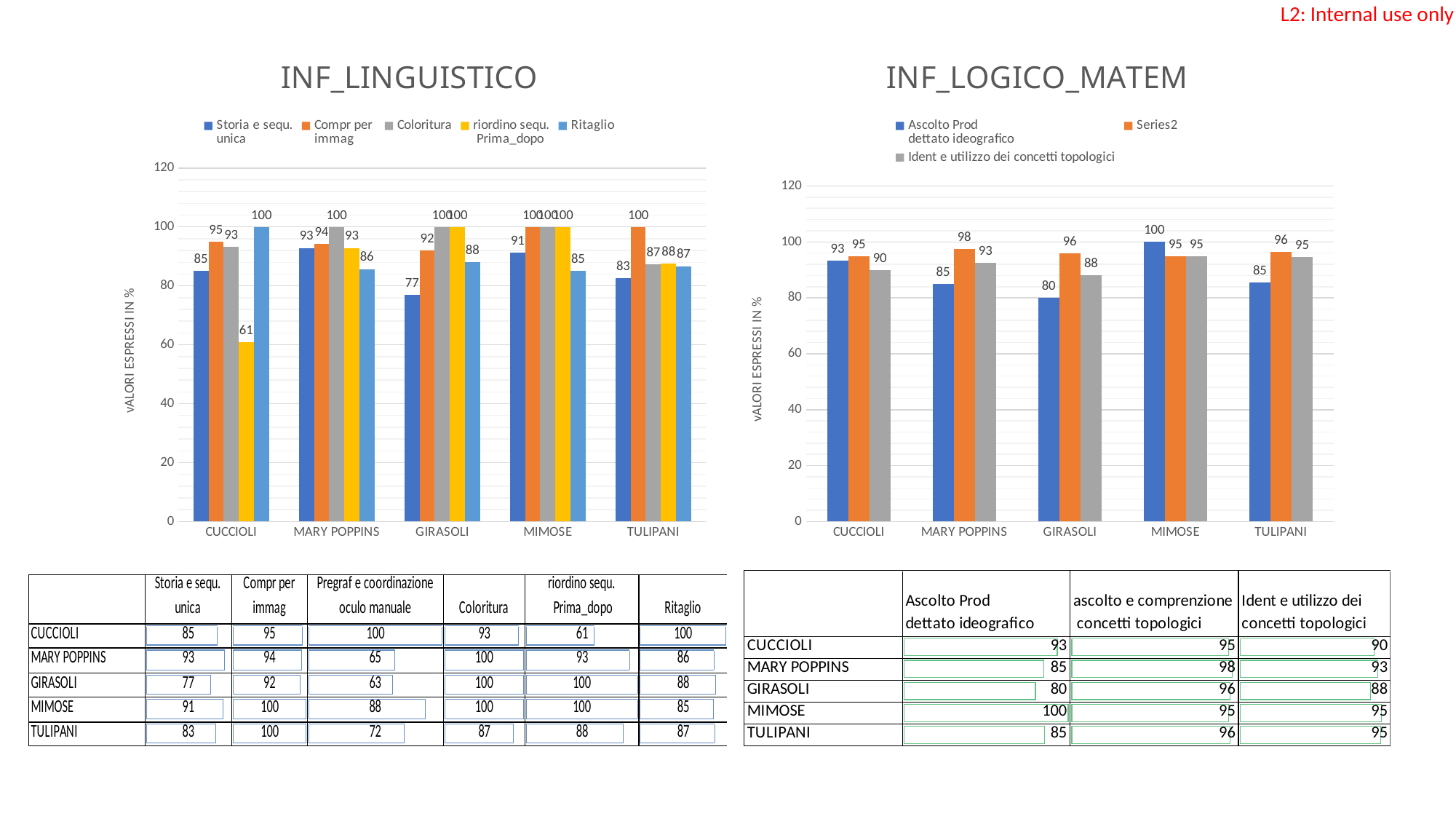
In the INF_LINGUISTICO chart, which category has the lowest value for Storia e sequ. unica? GIRASOLI In the INF_LINGUISTICO chart, what is the value of Storia e sequ. unica for GIRASOLI? 77 In the INF_LINGUISTICO chart, what is the difference between the Ritaglio values for CUCCIOLI and TULIPANI? 13 In the INF_LOGICO_MATEM chart, which category has the highest value for Ascolto Prod dettato ideografico? MIMOSE In the INF_LOGICO_MATEM chart, what is the difference between the Series2 and Ascolto Prod dettato ideografico values for GIRASOLI? 16 What kind of chart is INF_LOGICO_MATEM? Bar chart In the INF_LOGICO_MATEM chart, which is larger for MARY POPPINS: Series2 or Ident e utilizzo dei concetti topologici? Series2 In the INF_LINGUISTICO chart, is the Ritaglio value for MARY POPPINS greater or less than 80? greater In the INF_LOGICO_MATEM chart, how many categories are shown on the x axis? 5 In the INF_LOGICO_MATEM chart, what is the value of Ascolto Prod dettato ideografico for GIRASOLI? 80 In the INF_LINGUISTICO chart, what is the value of riordino sequ. Prima_dopo for CUCCIOLI? 61 In the INF_LINGUISTICO chart, how many series does the legend list? 5